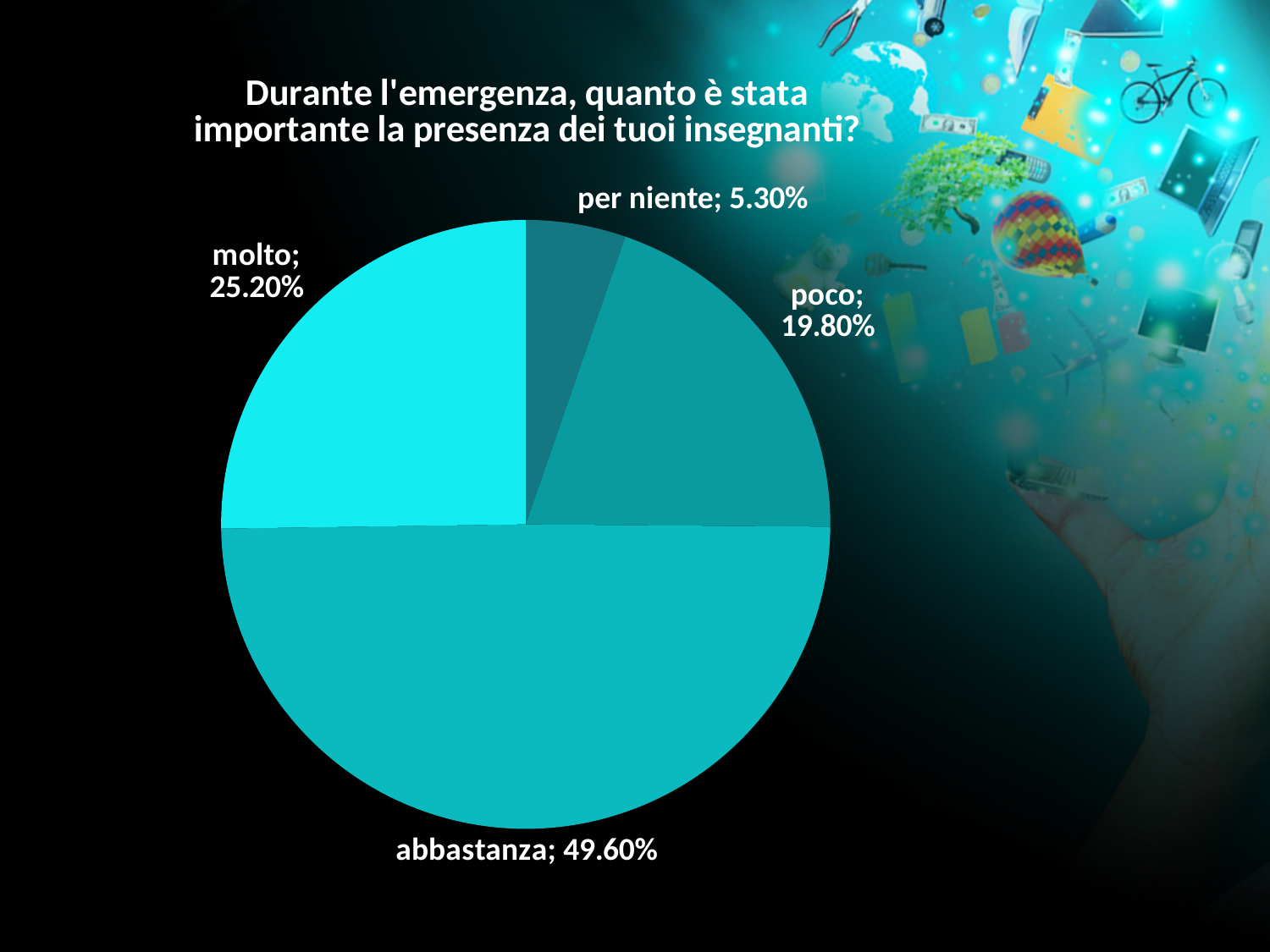
Which category has the smallest share of the pie? per niente What is the title of the chart? Durante l'emergenza, quanto è stata importante la presenza dei tuoi insegnanti? What kind of chart is shown on the slide? pie chart Which category has the largest share of the pie? abbastanza What is the difference between the share for "abbastanza" and the share for "molto"? 24.40% What is the value for "poco"? 19.80% What is the difference between the share for "poco" and the share for "per niente"? 14.50% How many categories are shown in the pie chart? 4 What is the value for "molto"? 25.20% Which is larger, the share for "molto" or the share for "poco"? molto What is the value for "per niente"? 5.30% What is the value for "abbastanza"? 49.60%